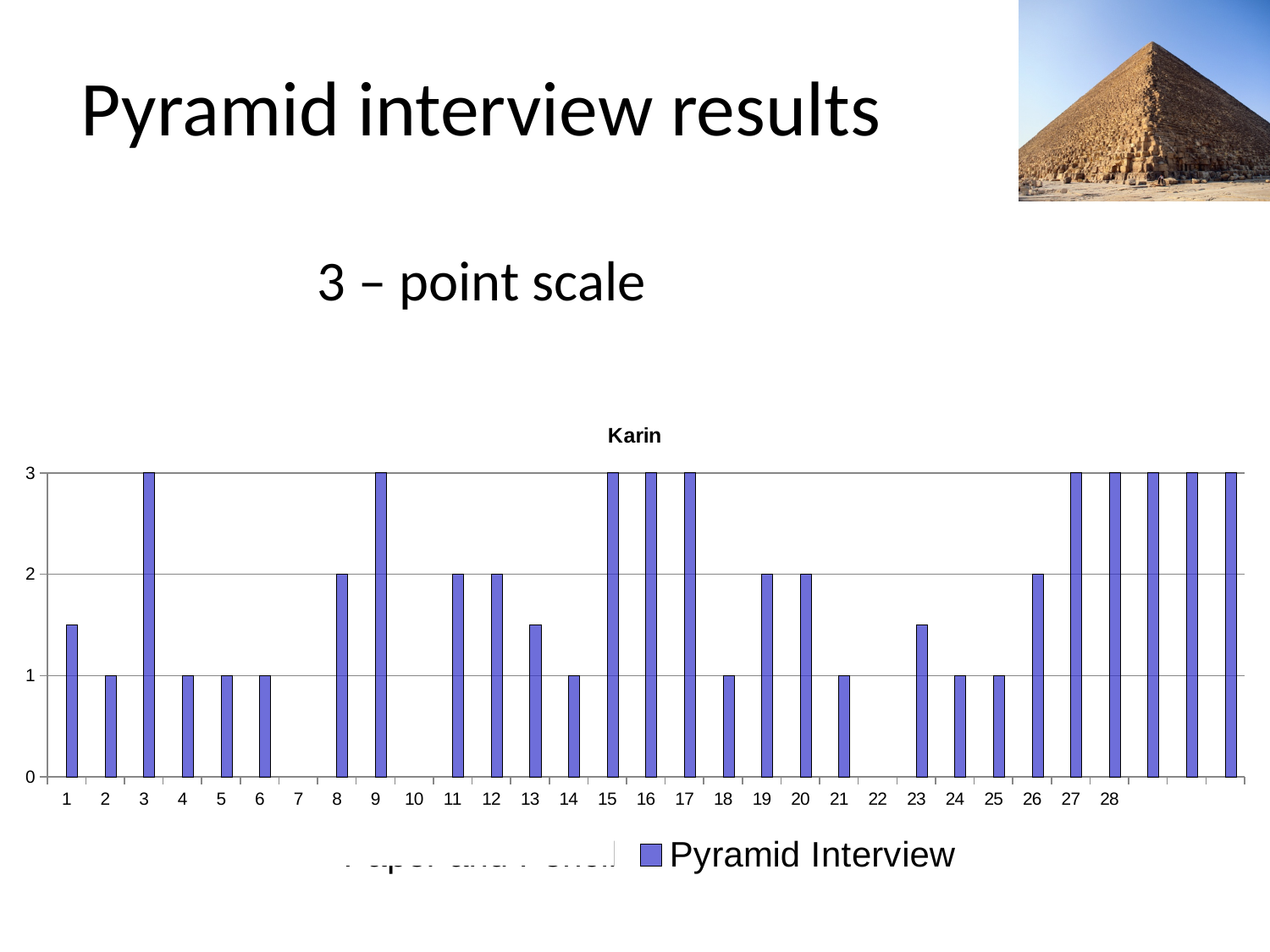
What is the value for category 27 in the Karin chart? 3 Which is larger, the value for category 9 or the value for category 11? category 9 What is the title of the chart? Karin What is the difference between the values for category 15 and category 18? 2 Is the value for category 23 greater or less than 1? greater What is the value for category 19 in the Karin chart? 2 What is the value for category 8 in the Karin chart? 2 Is the value for category 1 greater or less than 2? less What is the value for category 14 in the Karin chart? 1 What type of chart is shown on the slide? bar chart What is the value for category 3 in the Karin chart? 3 What is the highest value shown on the vertical axis of the chart? 3